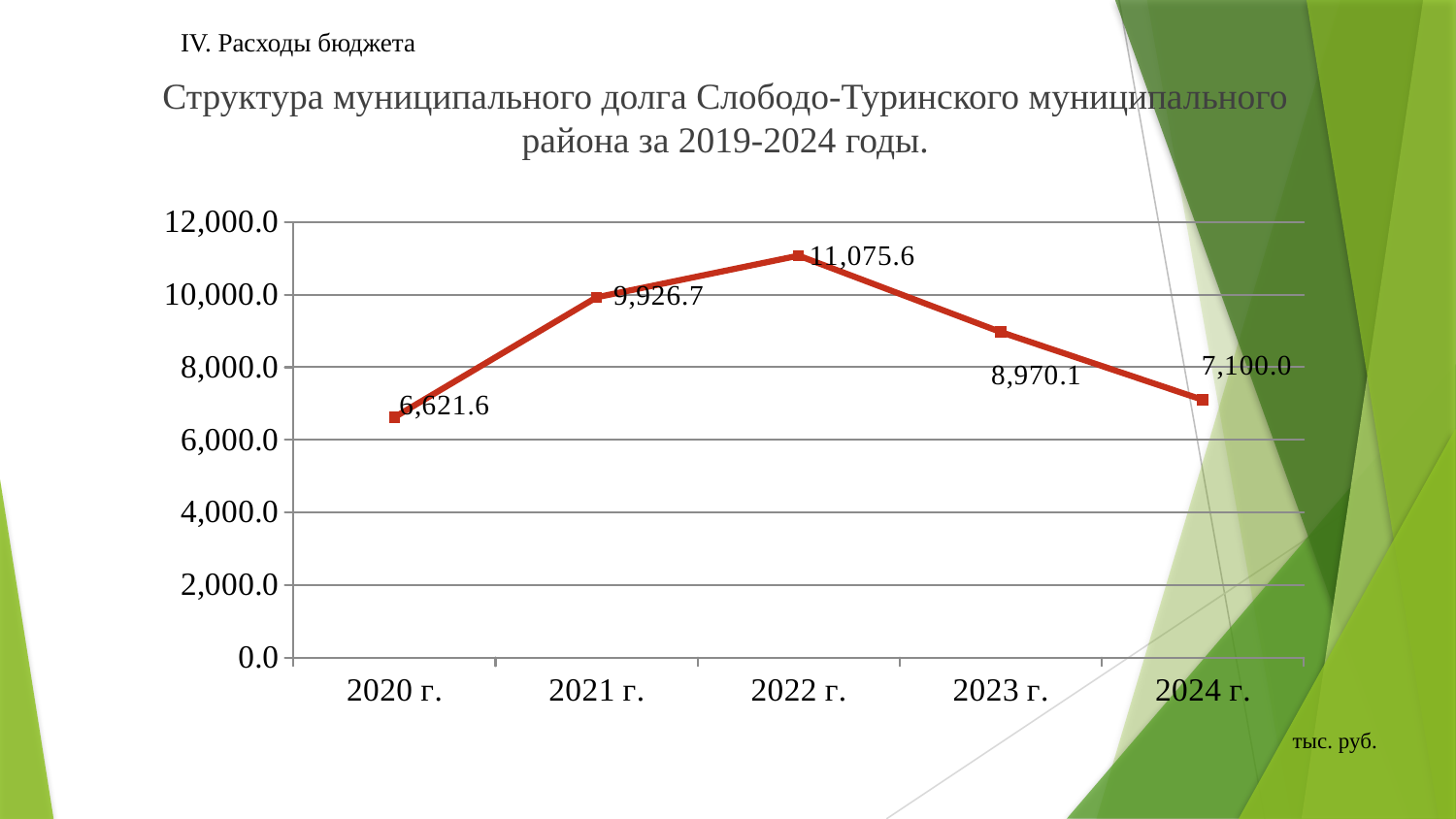
Which year has the lowest value? 2020 г. What is the value for 2023 г.? 8,970.1 What is the difference between the values for 2022 г. and 2021 г.? 1,148.9 How many years are plotted on the chart? 5 Which is larger, the value for 2021 г. or the value for 2023 г.? 2021 г. What is the difference between the values for 2023 г. and 2024 г.? 1,870.1 What is the value for 2024 г.? 7,100.0 What kind of chart is shown on the slide? line chart What is the value for 2020 г.? 6,621.6 What is the value for 2022 г.? 11,075.6 Which year has the highest value? 2022 г. Is the value for 2021 г. greater or less than 8,000.0? greater